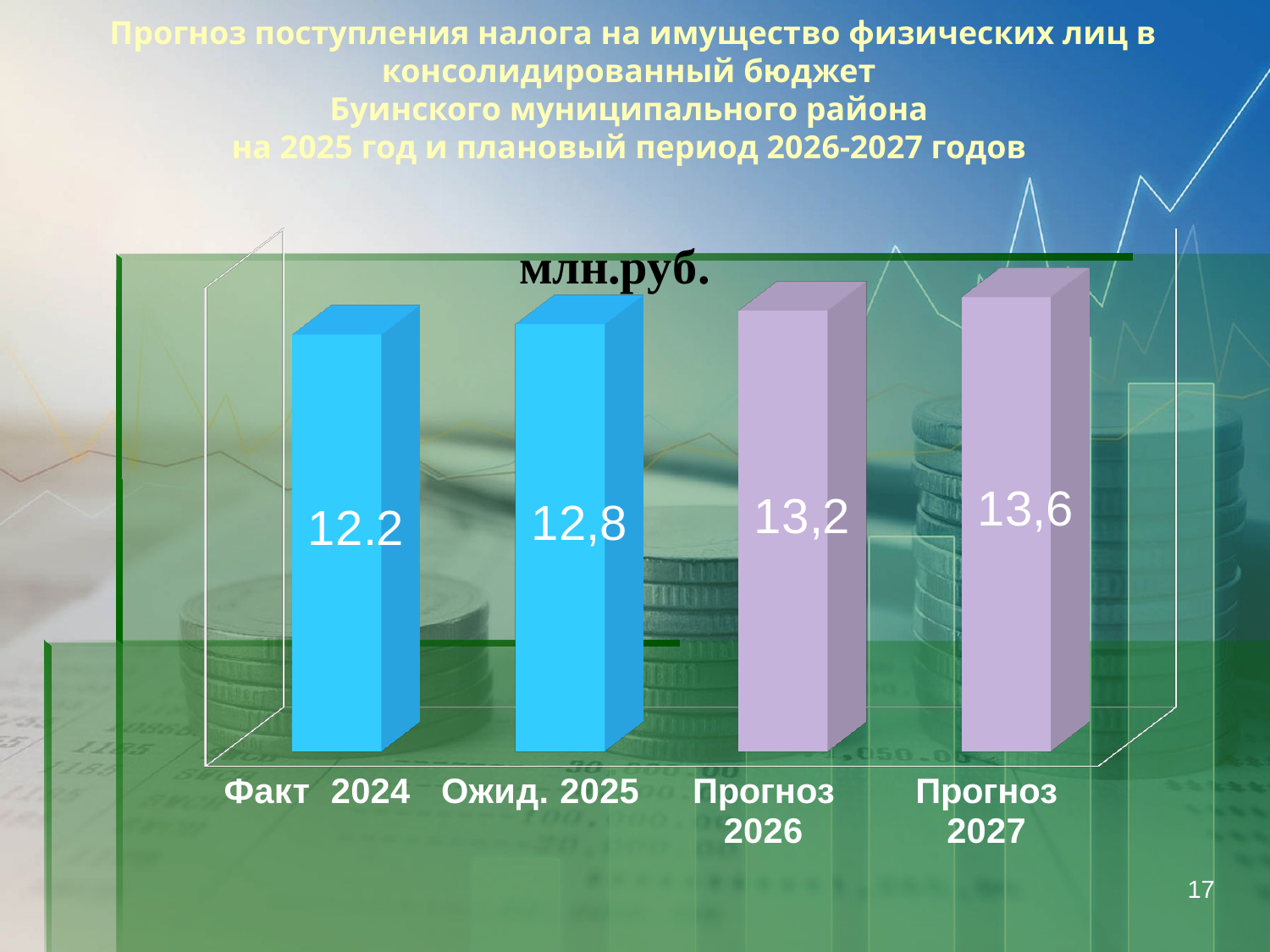
Which is larger, the value for Прогноз 2026 or the value for Факт 2024? Прогноз 2026 Which category has the highest value? Прогноз 2027 What is the value for Прогноз 2027? 13,6 Do the values rise or fall from Факт 2024 to Прогноз 2027? Rise What is the value for Прогноз 2026? 13,2 Which category has the lowest value? Факт 2024 What is the difference between the values for Прогноз 2027 and Ожид. 2025? 0,8 What is the value for Ожид. 2025? 12,8 What is the value for Факт 2024? 12.2 What kind of chart is shown on the slide? Bar chart What is the difference between the values for Прогноз 2026 and Ожид. 2025? 0,4 How many categories are shown in the chart? 4